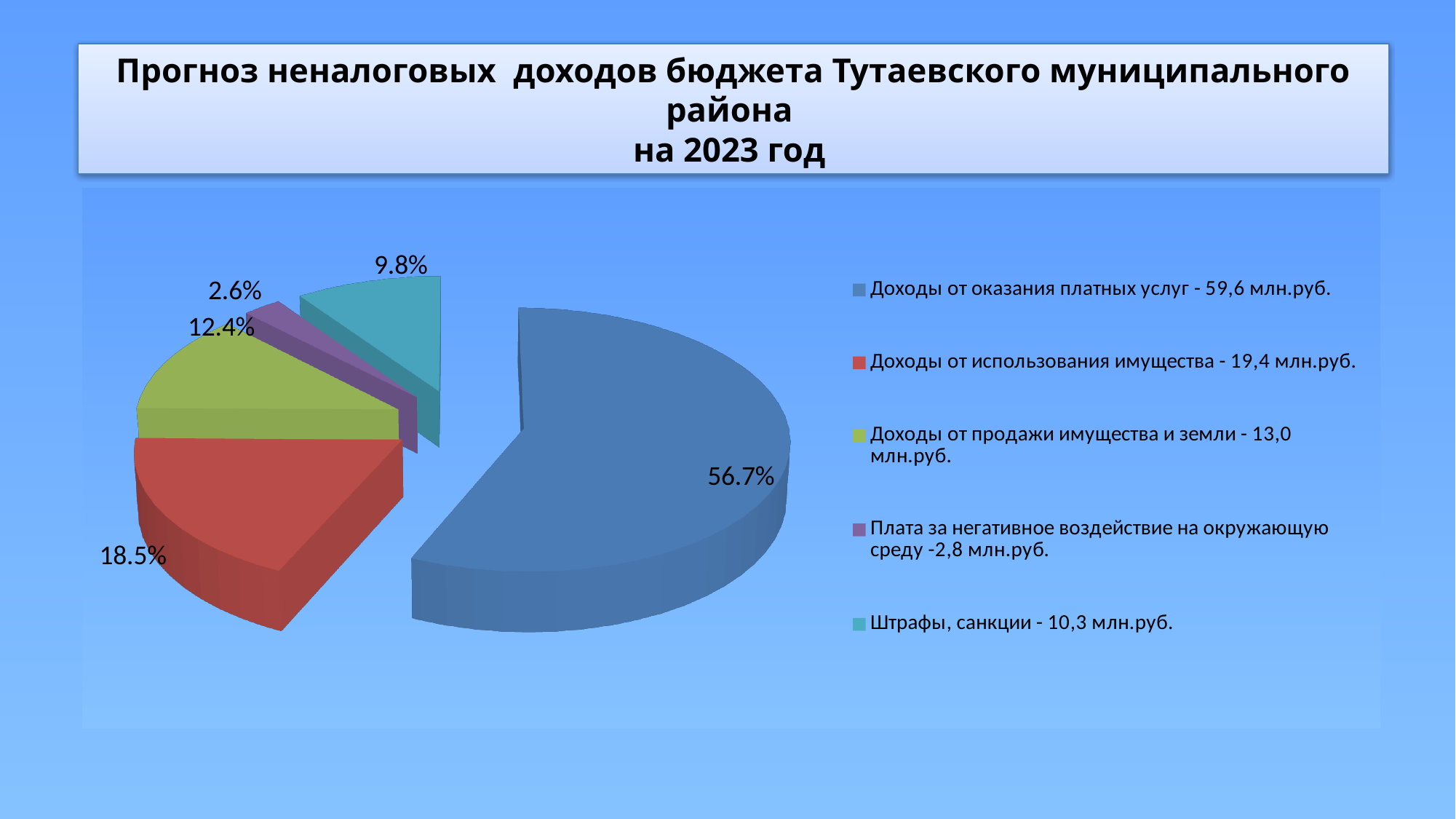
What share of the pie is labelled for "Доходы от оказания платных услуг"? 56.7% What share of the pie is labelled for "Доходы от продажи имущества и земли"? 12.4% What share of the pie is labelled for "Доходы от использования имущества"? 18.5% Which category has the smallest share of the pie? Плата за негативное воздействие на окружающую среду What type of chart is shown on the slide? pie chart How many slices does the pie chart have? 5 What is the difference in percentage points between the shares for "Доходы от использования имущества" and "Штрафы, санкции"? 8.7 According to the legend, what amount in млн.руб. is given for "Штрафы, санкции"? 10,3 млн.руб. Which has a larger share: "Доходы от продажи имущества и земли" or "Штрафы, санкции"? Доходы от продажи имущества и земли Which category has the largest share of the pie? Доходы от оказания платных услуг